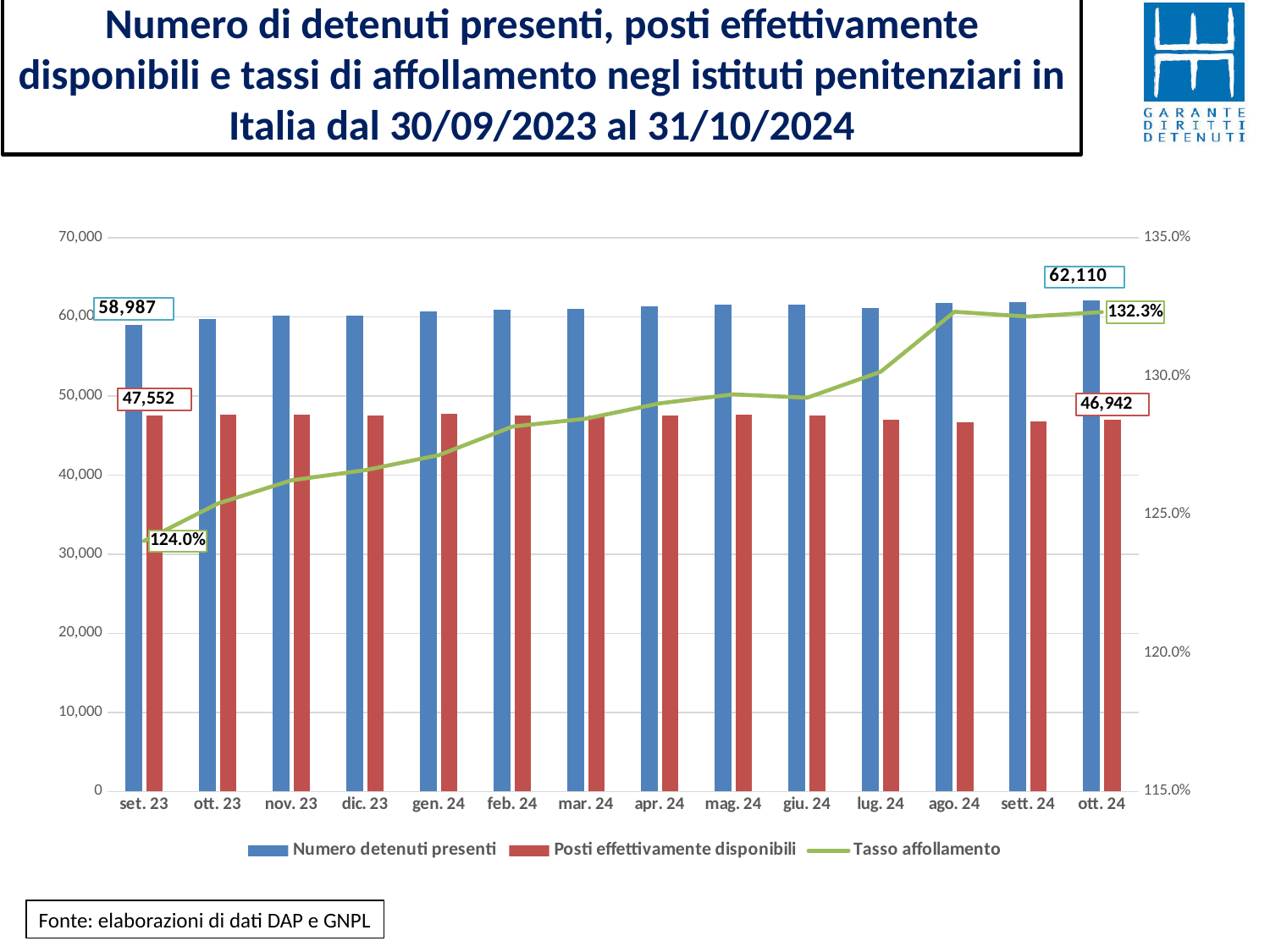
Is the value of Posti effettivamente disponibili for giu. 24 greater or less than 50,000? less What is the value of Posti effettivamente disponibili for set. 23? 47,552 In ott. 24, which is larger: Numero detenuti presenti or Posti effettivamente disponibili? Numero detenuti presenti What is the value of Numero detenuti presenti for set. 23? 58,987 How many series does the legend list? 3 What is the difference between Posti effettivamente disponibili in set. 23 and in ott. 24? 610 By how much did Numero detenuti presenti increase from set. 23 to ott. 24? 3,123 What is the value of Numero detenuti presenti for ott. 24? 62,110 What is the Tasso affollamento for set. 23? 124.0% How many months are shown on the x axis? 14 What is the Tasso affollamento for ott. 24? 132.3% Does the Tasso affollamento line generally rise or fall from set. 23 to ott. 24? rise